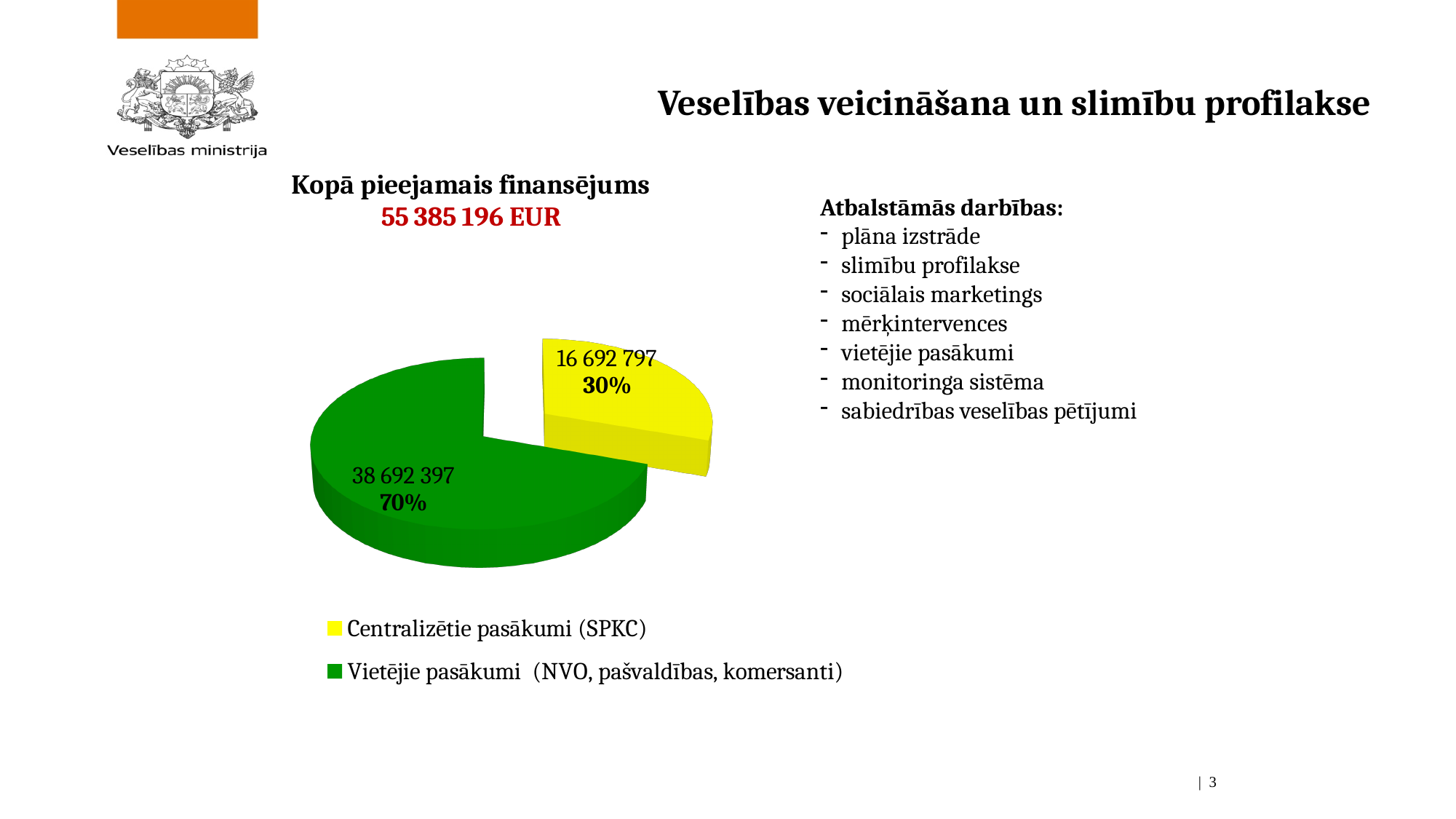
What is the value for Centralizētie pasākumi (SPKC)? 16 692 797 What share of the pie does Centralizētie pasākumi (SPKC) represent? 30% What is the value for Vietējie pasākumi (NVO, pašvaldības, komersanti)? 38 692 397 Which category has the largest slice of the pie? Vietējie pasākumi (NVO, pašvaldības, komersanti) Which category has the smallest slice of the pie? Centralizētie pasākumi (SPKC) What share of the pie does Vietējie pasākumi (NVO, pašvaldības, komersanti) represent? 70% How many categories does the pie chart have? 2 What is the difference between the values for Vietējie pasākumi and Centralizētie pasākumi? 21 999 600 Which is larger: the value for Centralizētie pasākumi (SPKC) or the value for Vietējie pasākumi? Vietējie pasākumi What colour is the slice for Centralizētie pasākumi (SPKC)? Yellow What total available funding is stated above the chart? 55 385 196 EUR What type of chart is shown on the slide? Pie chart